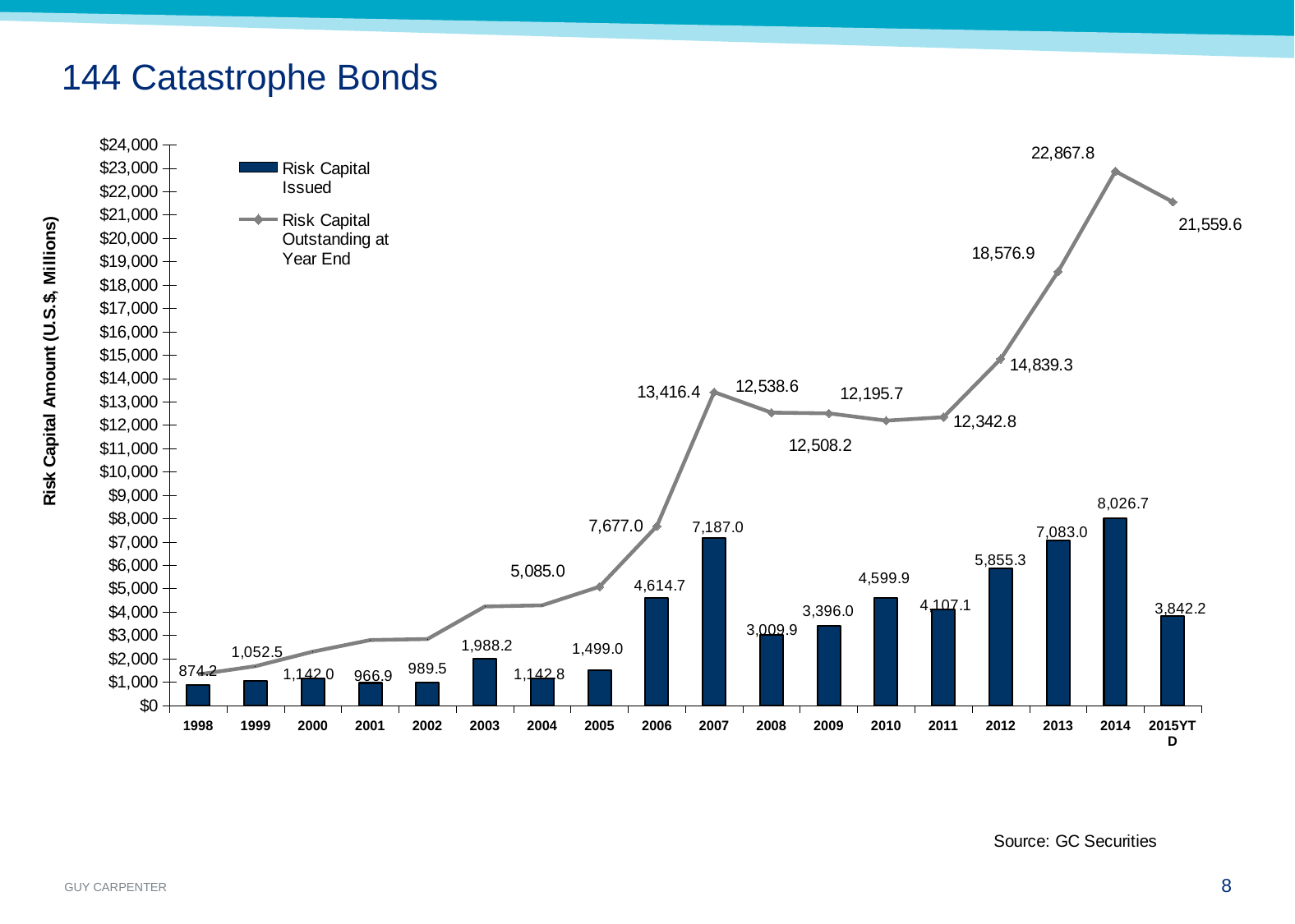
How many years are shown on the x axis? 18 Which year has the highest Risk Capital Issued bar? 2014 Does Risk Capital Outstanding at Year End rise or fall from 2011 to 2014? Rise Is the Risk Capital Outstanding at Year End value for 2001 greater or less than $2,000? greater What is the Risk Capital Issued value for 2014? 8,026.7 What is the label on the vertical axis? Risk Capital Amount (U.S.$, Millions) What kind of chart is shown on the slide? Combined bar and line chart Which year has the lowest Risk Capital Issued bar? 1998 How many series does the legend list? 2 What is the Risk Capital Outstanding at Year End value for 2014? 22,867.8 Which year has the larger Risk Capital Issued value, 2007 or 2013? 2007 What is the difference between Risk Capital Issued in 2014 and in 2013? 943.7